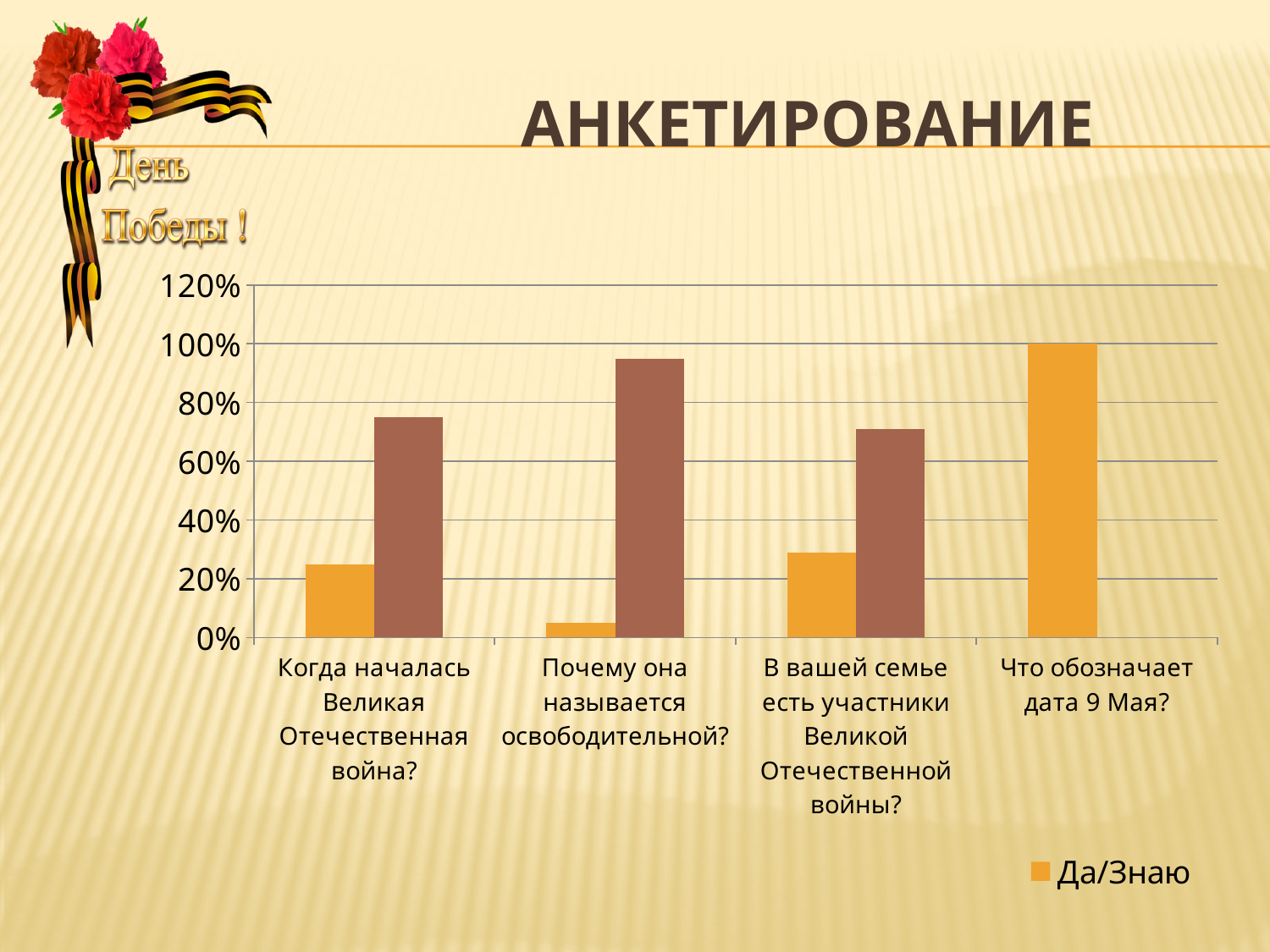
Is the Да/Знаю value for "Когда началась Великая Отечественная война?" greater or less than 40%? less Which category has the larger Да/Знаю value: "Когда началась Великая Отечественная война?" or "Почему она называется освободительной?"? Когда началась Великая Отечественная война? Which category has the lowest Да/Знаю value? Почему она называется освободительной? How many series does the chart's legend list? 1 What kind of chart is shown on the slide? bar chart What is the Да/Знаю value for "Что обозначает дата 9 Мая?"? 100% What is the title of the slide containing the chart? Анкетирование Is the Да/Знаю value for "В вашей семье есть участники Великой Отечественной войны?" greater or less than 20%? greater How many question categories are shown on the x axis of the chart? 4 Which category has the highest Да/Знаю value? Что обозначает дата 9 Мая? Is the brown bar for "Почему она называется освободительной?" greater or less than 80%? greater Which is larger for "Когда началась Великая Отечественная война?": the orange Да/Знаю bar or the brown bar? the brown bar